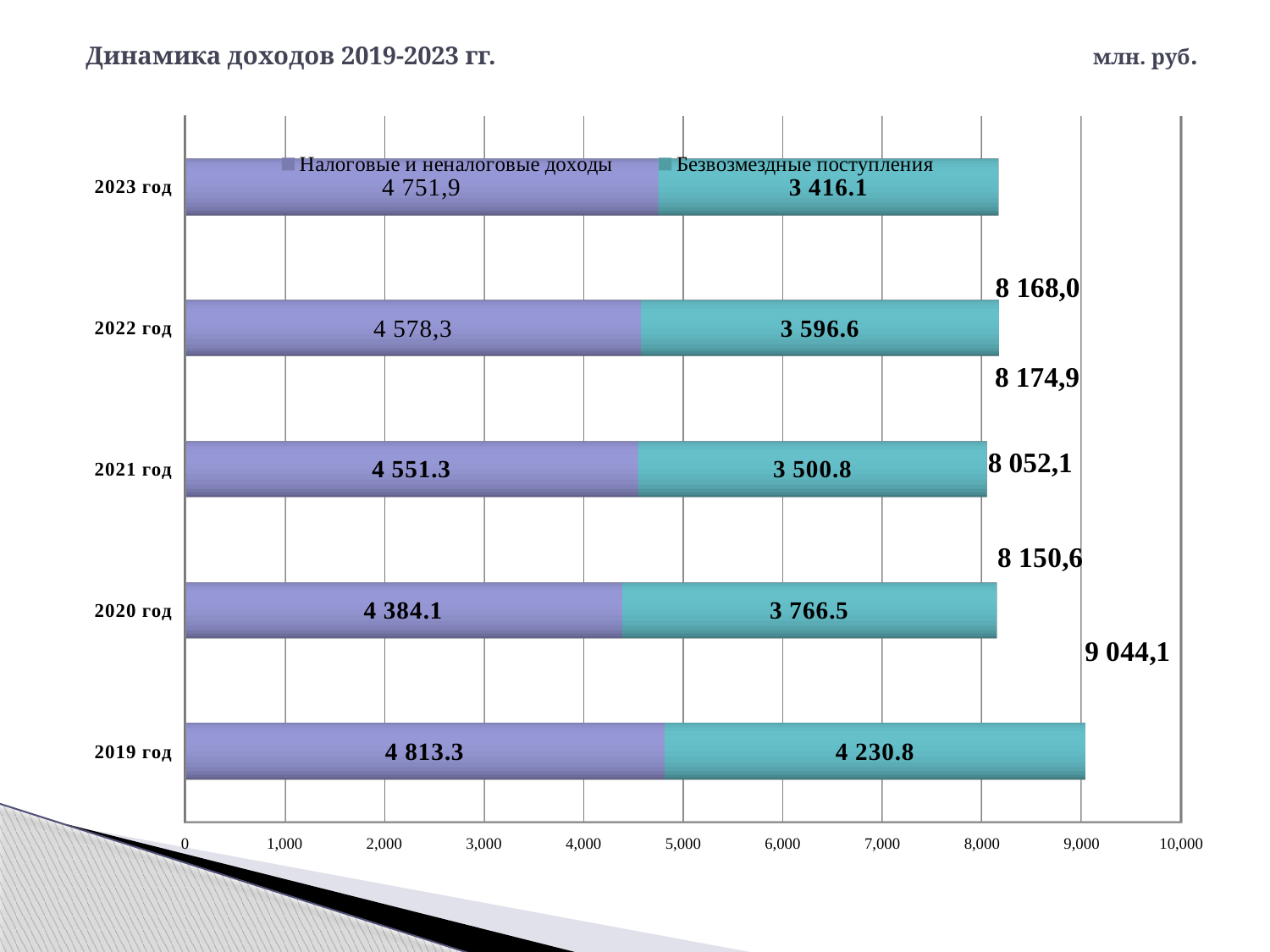
What is the value of Безвозмездные поступления for 2020 год? 3 766.5 Which is larger for 2022 год: Налоговые и неналоговые доходы or Безвозмездные поступления? Налоговые и неналоговые доходы How many years are shown on the chart? 5 What is the value of Безвозмездные поступления for 2022 год? 3 596.6 What type of chart is shown on the slide? Stacked bar chart What is the value of Налоговые и неналоговые доходы for 2023 год? 4 751,9 What is the difference between Налоговые и неналоговые доходы and Безвозмездные поступления for 2019 год? 582.5 Which year has the highest value of Безвозмездные поступления? 2019 год What is the value of Налоговые и неналоговые доходы for 2021 год? 4 551.3 What is the total of the stacked bar for 2019 год? 9 044,1 How many series does the legend list? 2 Which year has the lowest value of Налоговые и неналоговые доходы? 2020 год